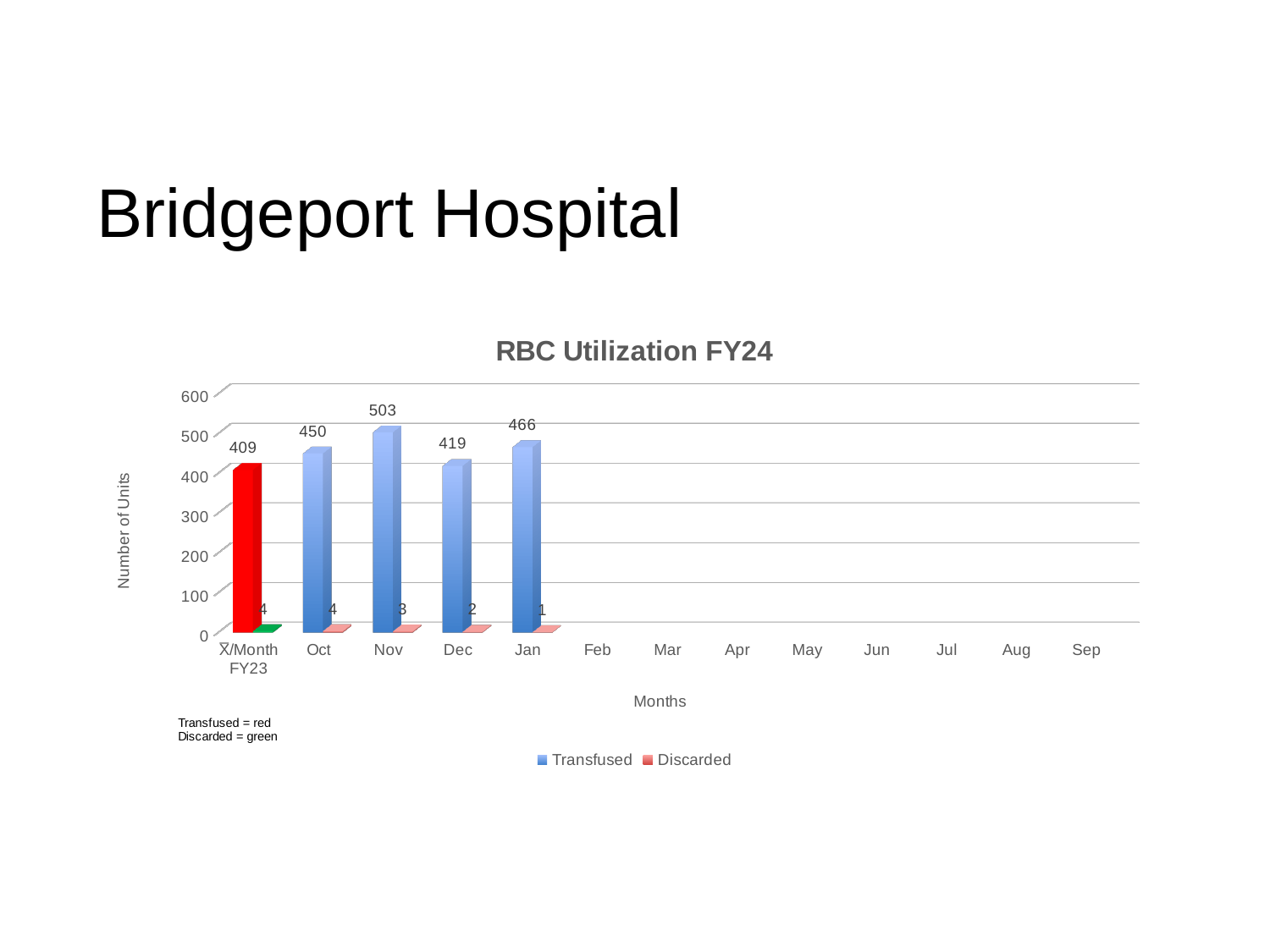
How many series does the legend list? 2 What kind of chart is shown? Bar chart Which is larger, the Transfused value for Oct or for Jan? Jan What is the difference between the Transfused values for Nov and Dec? 84 Is the Transfused value for Nov greater or less than 500? greater Which month has the highest Transfused value? Nov What is the title of the chart? RBC Utilization FY24 Which category has the lowest Transfused value among those with data? X̄/Month FY23 What is the Transfused value for the X̄/Month FY23 category? 409 What is the Discarded value for Jan? 1 What is the Transfused value for Nov? 503 What is the Transfused value for Dec? 419